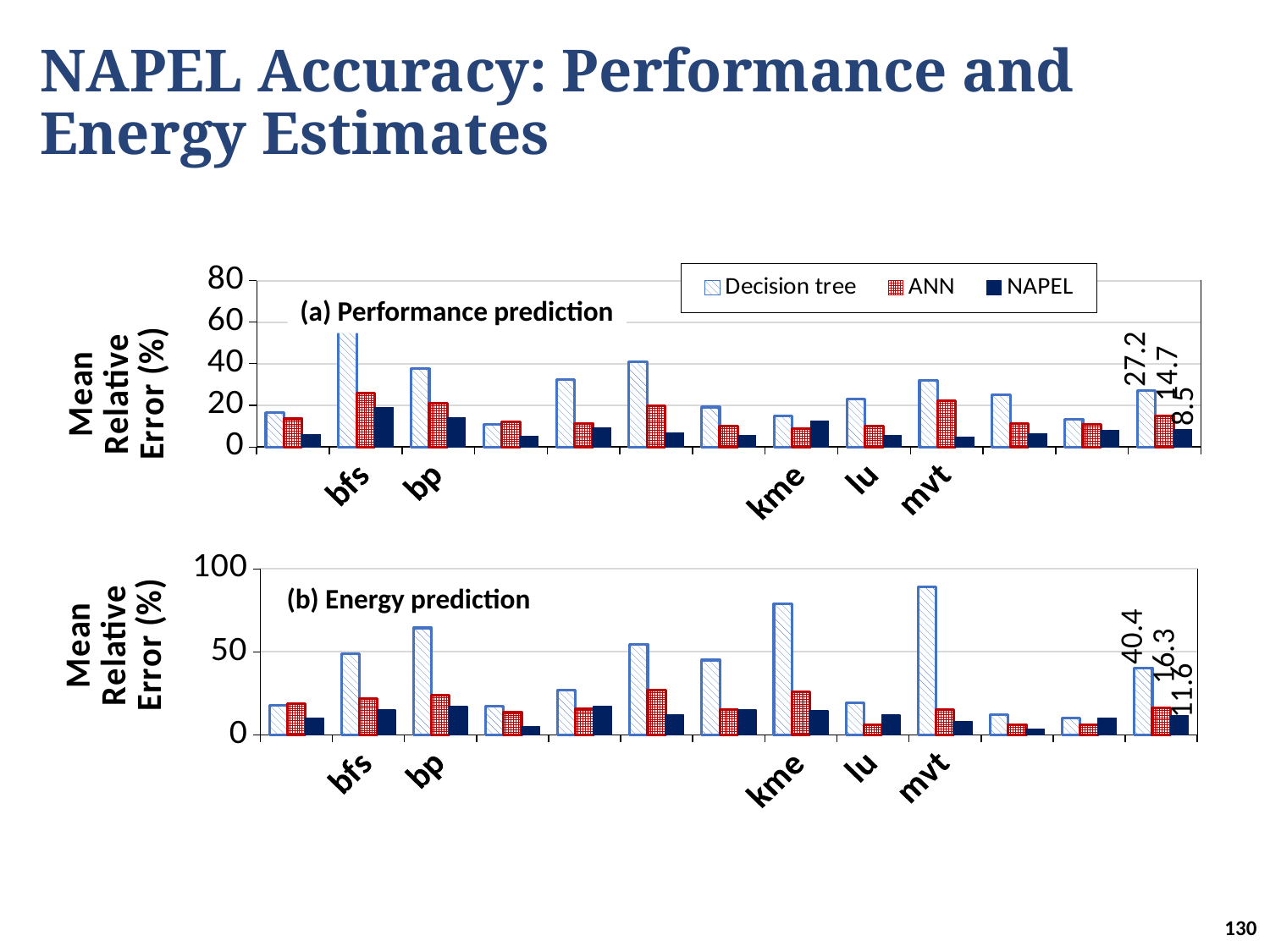
In the (a) Performance prediction chart, what is the difference between the printed Decision tree value (27.2) and the printed ANN value (14.7) in the rightmost group? 12.5 In the (b) Energy prediction chart, what is the printed ANN value for the rightmost group of bars? 16.3 In the (a) Performance prediction chart, what is the printed NAPEL value for the rightmost group of bars? 8.5 In the (a) Performance prediction chart, what is the printed Decision tree value for the rightmost group of bars? 27.2 In the (b) Energy prediction chart, which is larger for kme: the Decision tree bar or the ANN bar? Decision tree What kind of chart is used in the (a) Performance prediction panel? bar chart In the (b) Energy prediction chart, is the Decision tree value for mvt greater or less than 50? greater What are the three series named in the legend? Decision tree, ANN, NAPEL In the (a) Performance prediction chart, is the Decision tree value for bfs greater or less than 40? greater How many series does the legend list for the charts? 3 In the (b) Energy prediction chart, what is the difference between the printed Decision tree value (40.4) and the printed NAPEL value (11.6) in the rightmost group? 28.8 In the (b) Energy prediction chart, what is the printed NAPEL value for the rightmost group of bars? 11.6